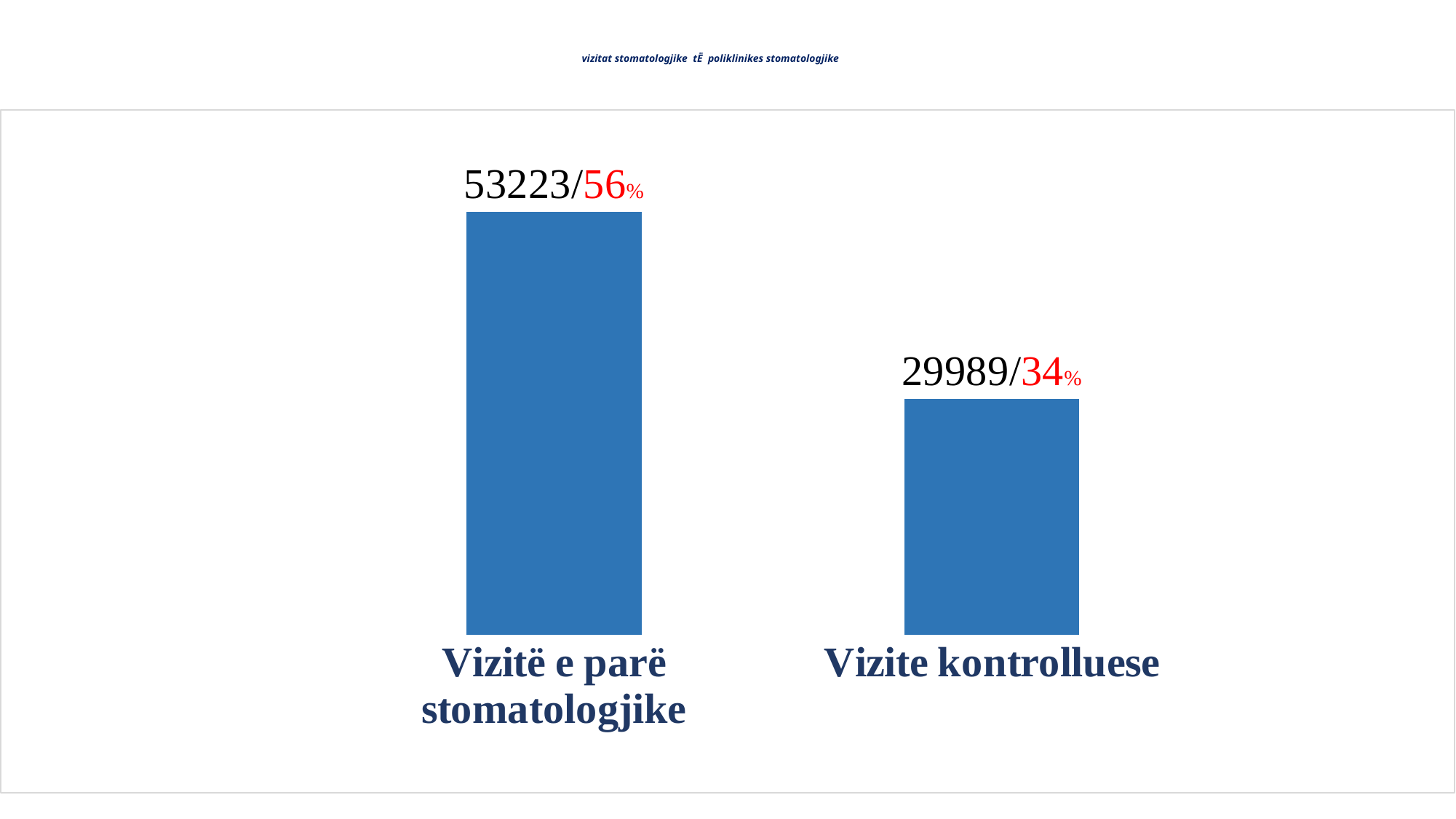
What is the difference in percentage points between the two categories? 22 What kind of chart is shown on the slide? bar chart Which category has the lowest value? Vizite kontrolluese What colour are the bars in the chart? blue What percentage is shown for Vizite kontrolluese? 34% Which category has the highest value? Vizitë e parë stomatologjike Which is larger, the value for Vizitë e parë stomatologjike or the value for Vizite kontrolluese? Vizitë e parë stomatologjike What is the difference in visits between Vizitë e parë stomatologjike and Vizite kontrolluese? 23234 What percentage is shown for Vizitë e parë stomatologjike? 56% What is the number of visits shown for Vizite kontrolluese? 29989 How many categories does the chart show? 2 What is the number of visits shown for Vizitë e parë stomatologjike? 53223